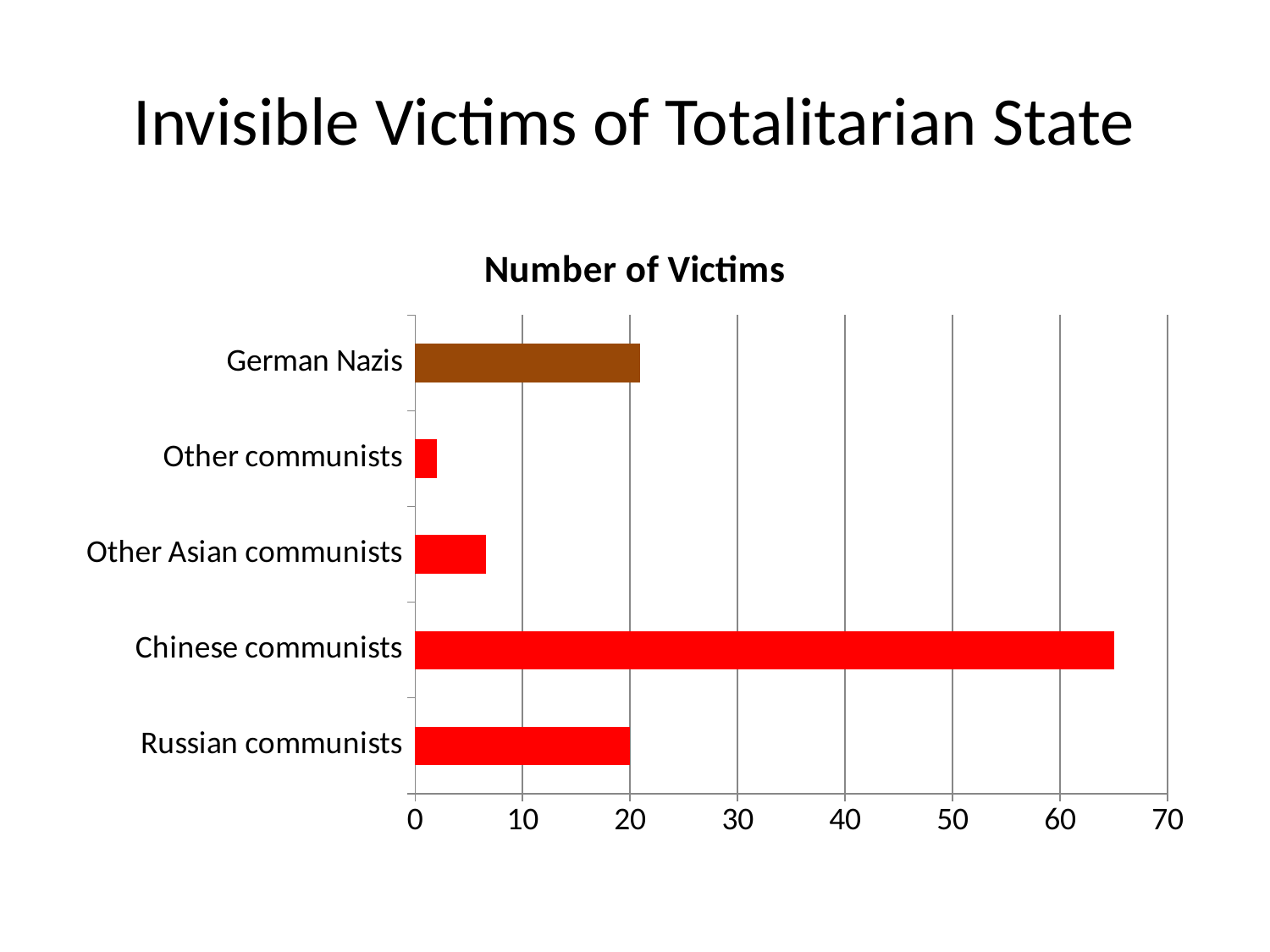
Which has a larger value, Other Asian communists or Other communists? Other Asian communists Is the value for German Nazis greater or less than 30? less What is the title of the chart? Number of Victims What is the value for Russian communists? 20 Which category has the highest number of victims? Chinese communists Which category has the lowest number of victims? Other communists What kind of chart is shown on the slide? bar chart How many categories are plotted in the chart? 5 Which has a larger value, Chinese communists or Russian communists? Chinese communists Which category's bar is coloured brown rather than red? German Nazis Is the value for Other Asian communists greater or less than 10? less Is the value for Chinese communists greater or less than 60? greater